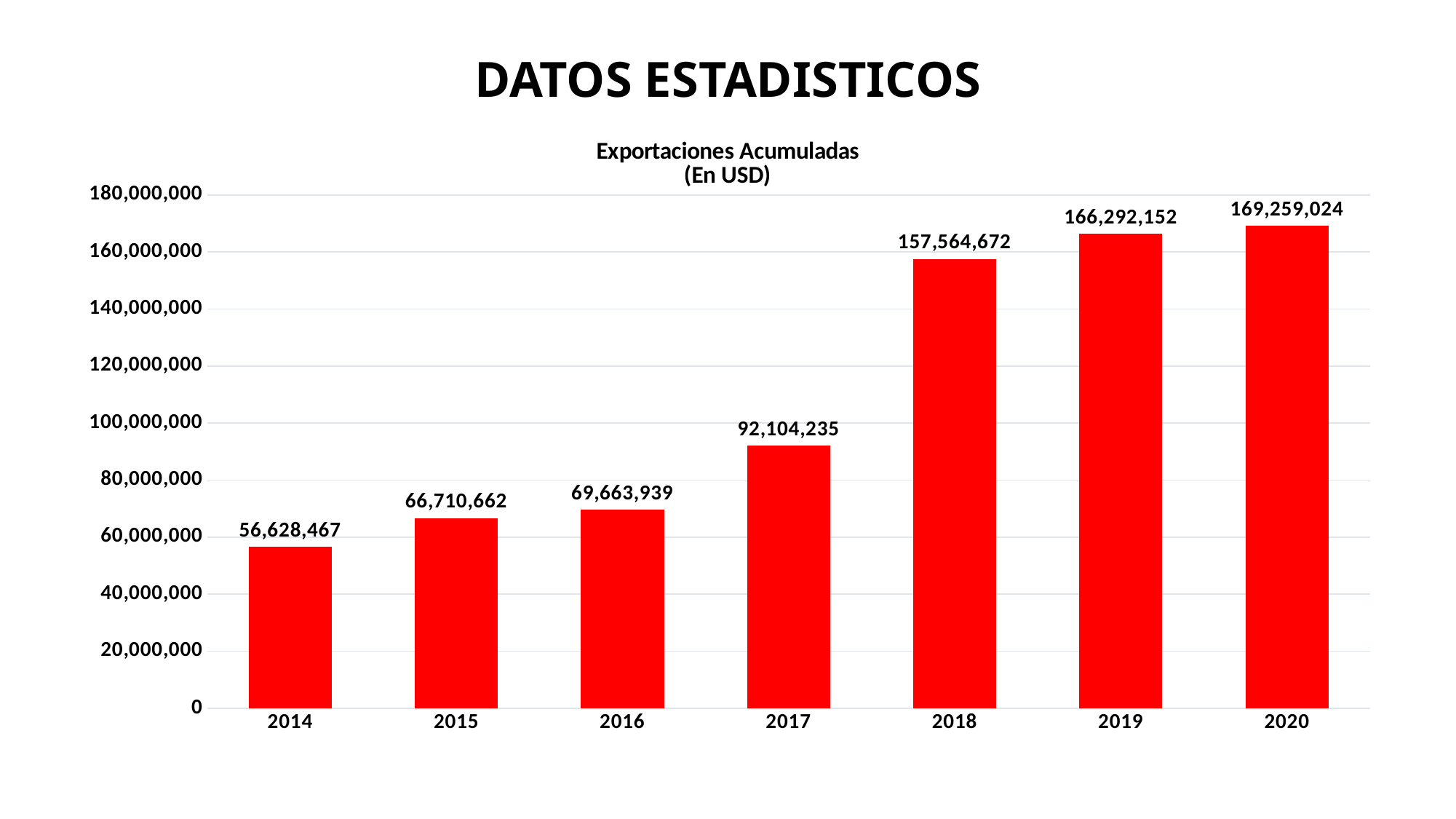
Is the value for 2018 greater or less than 140,000,000? greater What is the value for 2019? 166,292,152 What is the value for 2014? 56,628,467 How many years are shown on the x axis? 7 Do the values rise or fall from 2014 to 2020? rise What kind of chart is shown? bar chart Which is larger, the value for 2016 or the value for 2017? 2017 Which year has the highest value? 2020 What is the difference between the values for 2018 and 2017? 65,460,437 What is the value for 2017? 92,104,235 Which year has the lowest value? 2014 What is the difference between the values for 2015 and 2014? 10,082,195